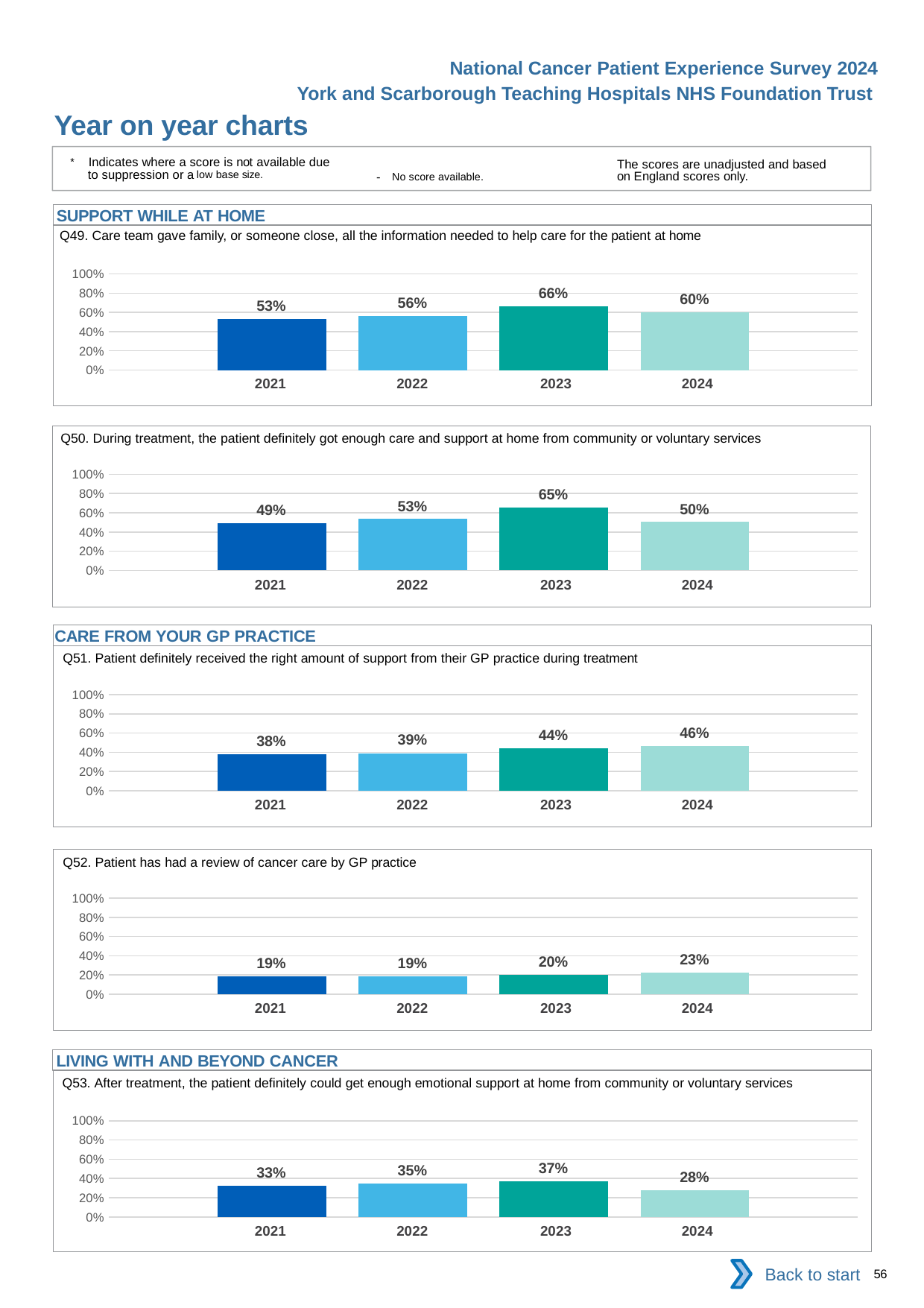
In the Q53 chart, what is the value for 2024? 28% Which section heading appears above the Q53 chart? LIVING WITH AND BEYOND CANCER In the Q49 chart, what is the value for 2023? 66% In the Q50 chart, what is the difference between the 2023 and 2024 values? 15% How many years are shown in the Q51 chart? 4 What kind of chart is the Q52 chart? bar chart In the Q51 chart, do the values rise or fall from 2021 to 2024? rise In the Q49 chart, is the value for 2024 larger or smaller than the value for 2023? smaller In the Q52 chart, which year has the highest value? 2024 In the Q50 chart, which year has the lowest value? 2021 In the Q51 chart, what is the difference between the 2024 and 2021 values? 8% In the Q53 chart, is the value for 2023 greater or less than 40%? less